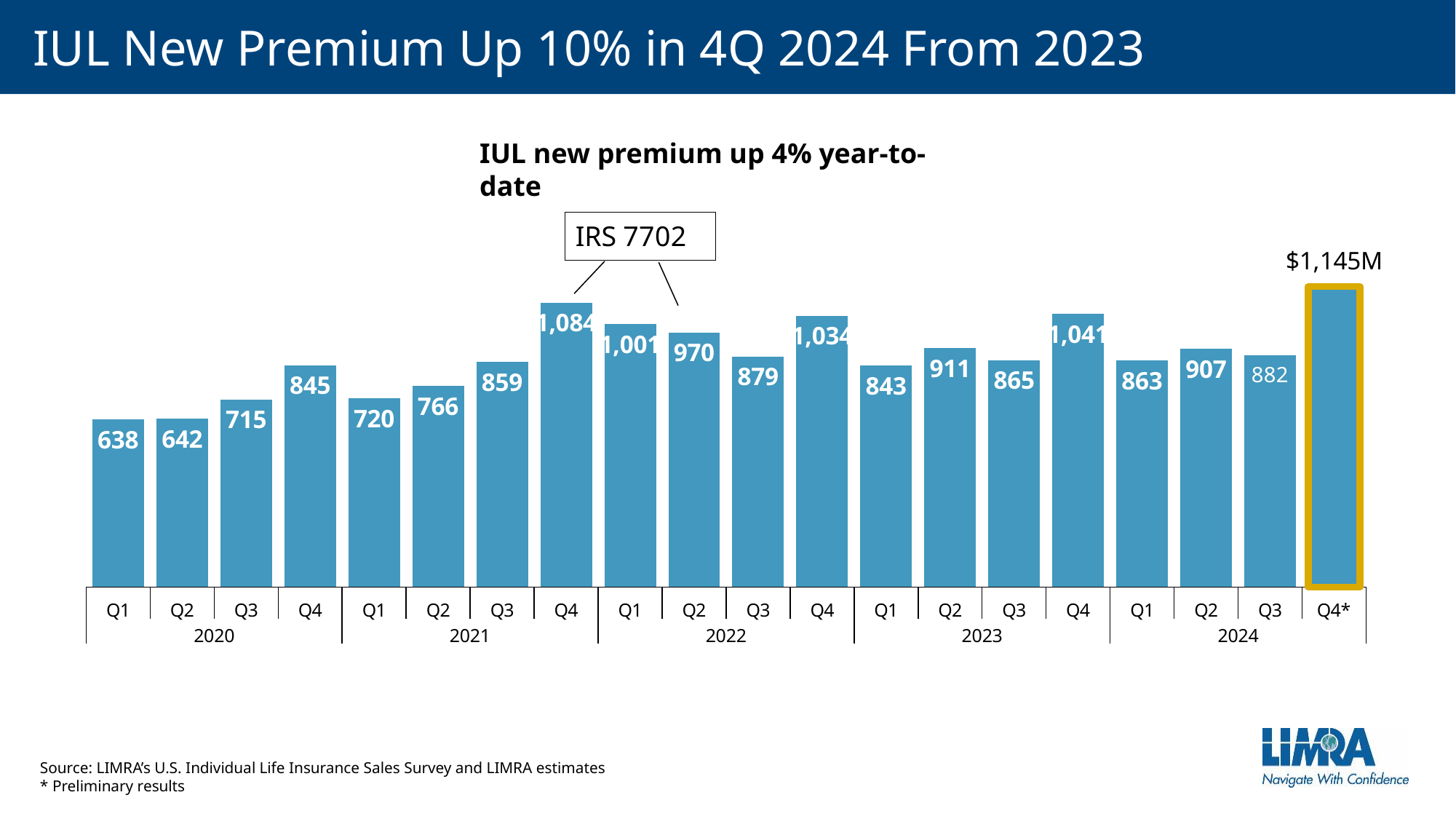
What is the difference between Q4 2021 and Q4 2020? 239 What label is shown in the callout box above the Q4 2021 and Q2 2022 bars? IRS 7702 What is the value for Q4 2021? 1,084 Do the values rise or fall from Q1 2020 to Q4 2020? Rise How many quarterly bars are plotted on the chart? 20 What is the value for Q4 2024? $1,145M What is the value for Q3 2024? 882 Which quarter has the lowest value? Q1 2020 Which is larger, Q2 2022 or Q2 2023? Q2 2022 What kind of chart is shown on the slide? Bar chart Which quarter has the highest value? Q4 2024 What is the value for Q1 2020? 638